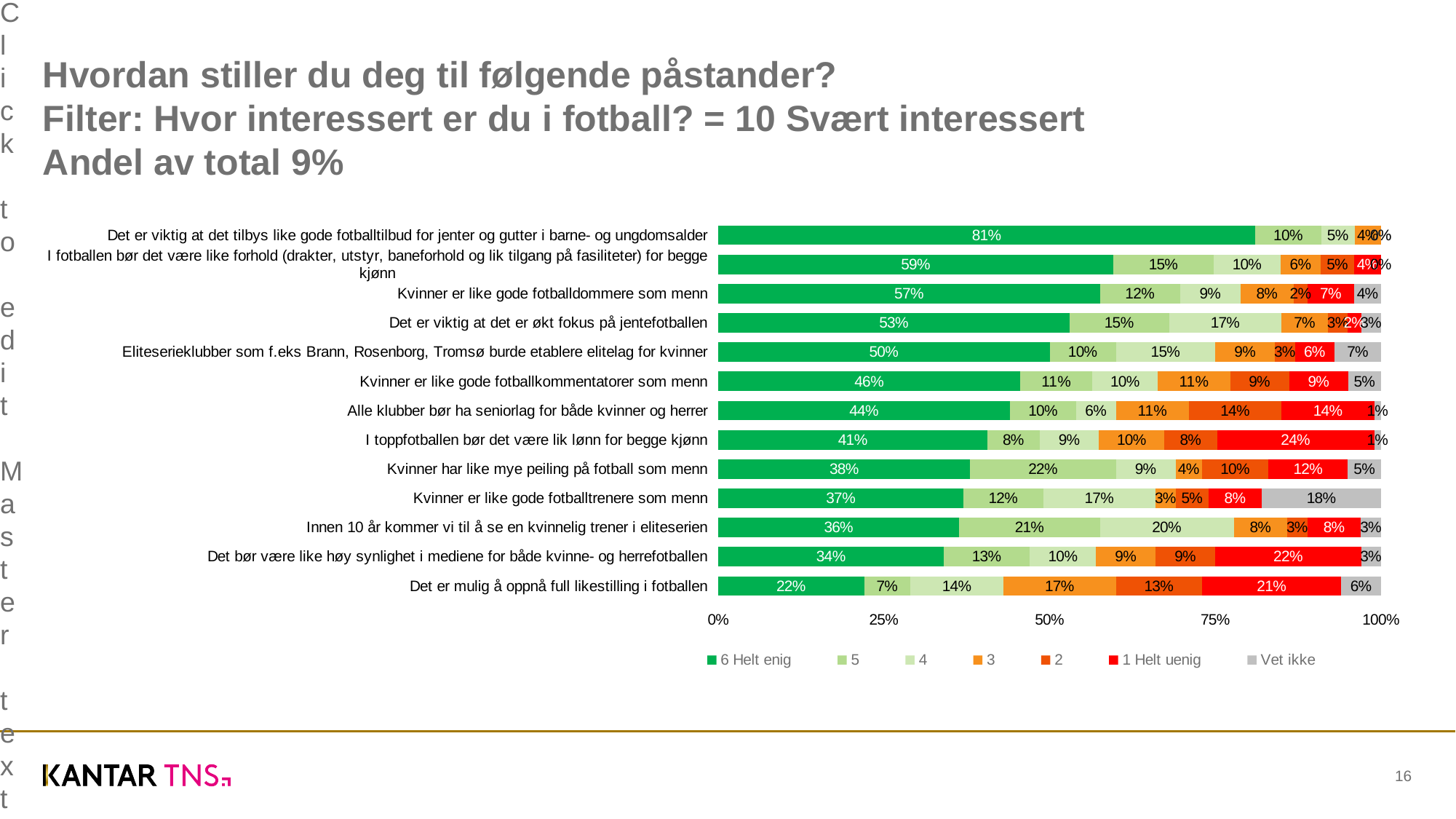
How many series does the legend list? 7 What is the difference between the '6 Helt enig' values for 'Kvinner er like gode fotballdommere som menn' and 'Kvinner er like gode fotballkommentatorer som menn'? 11% What is the 'Vet ikke' value for 'Kvinner er like gode fotballtrenere som menn'? 18% How many statements (categories) are plotted in the chart? 13 What kind of chart is shown on the slide? Stacked bar chart Which statement has the highest '1 Helt uenig' value? I toppfotballen bør det være lik lønn for begge kjønn Which has a larger '6 Helt enig' value: 'Kvinner har like mye peiling på fotball som menn' or 'Innen 10 år kommer vi til å se en kvinnelig trener i eliteserien'? Kvinner har like mye peiling på fotball som menn What is the '6 Helt enig' value for 'Det er viktig at det tilbys like gode fotballtilbud for jenter og gutter i barne- og ungdomsalder'? 81% What is the '1 Helt uenig' value for 'I toppfotballen bør det være lik lønn for begge kjønn'? 24% Which legend entry is shown in grey? Vet ikke What is the '5' value for 'Kvinner har like mye peiling på fotball som menn'? 22% Which statement has the lowest '6 Helt enig' value? Det er mulig å oppnå full likestilling i fotballen